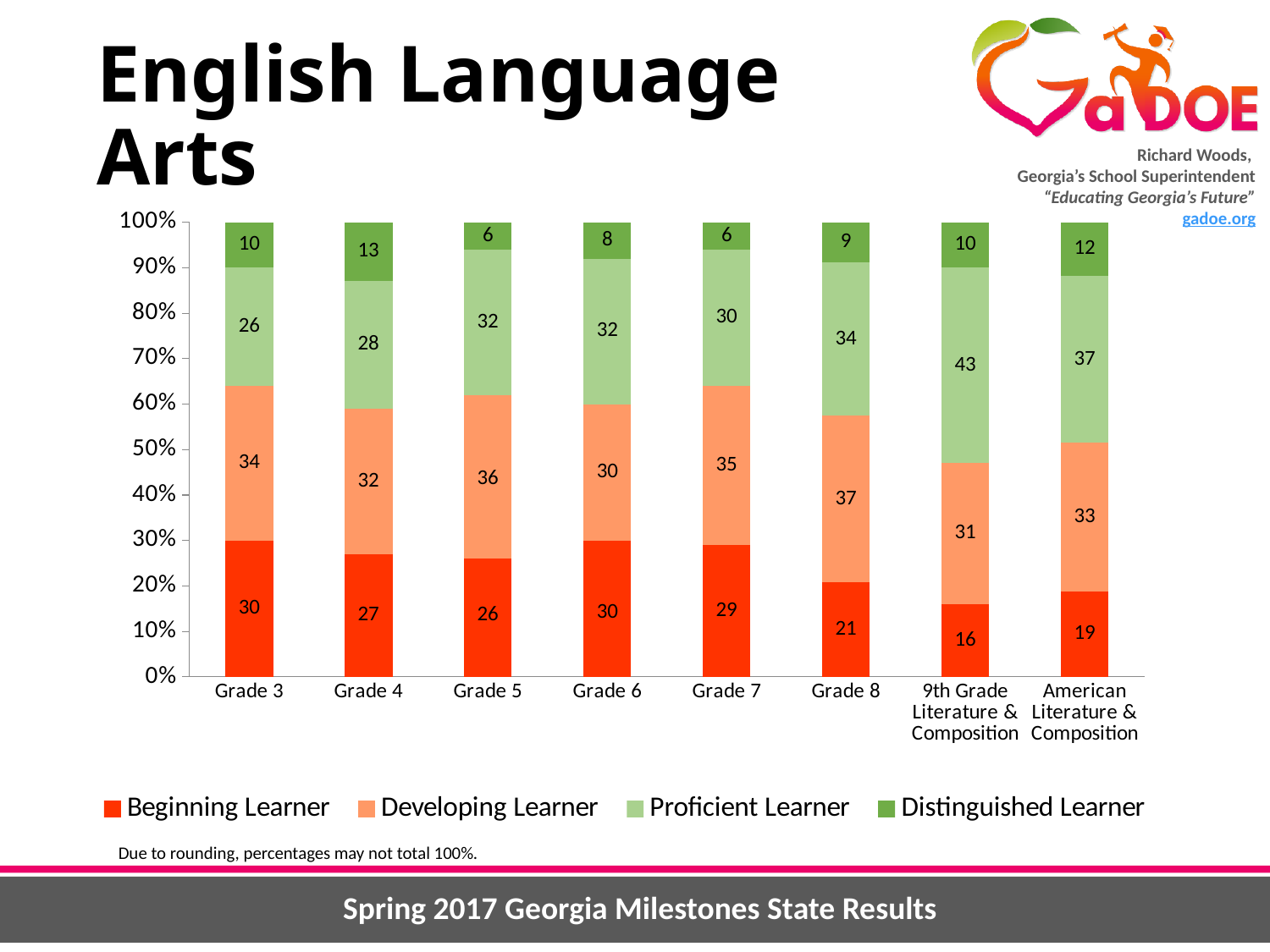
Which category has the lowest Beginning Learner value? 9th Grade Literature & Composition What is the Proficient Learner value for 9th Grade Literature & Composition? 43 What is the difference between the Developing Learner values for Grade 8 and Grade 6? 7 What is the Beginning Learner value for Grade 8? 21 Which is larger, the Proficient Learner value for Grade 5 or for Grade 3? Grade 5 What kind of chart is shown on the slide? Stacked bar chart How many categories are shown on the x axis? 8 What is the difference between the Beginning Learner values for Grade 3 and 9th Grade Literature & Composition? 14 Which legend entry is shown in the darkest green colour? Distinguished Learner Which category has the highest Distinguished Learner value? Grade 4 What is the Distinguished Learner value for American Literature & Composition? 12 How many series does the legend list? 4